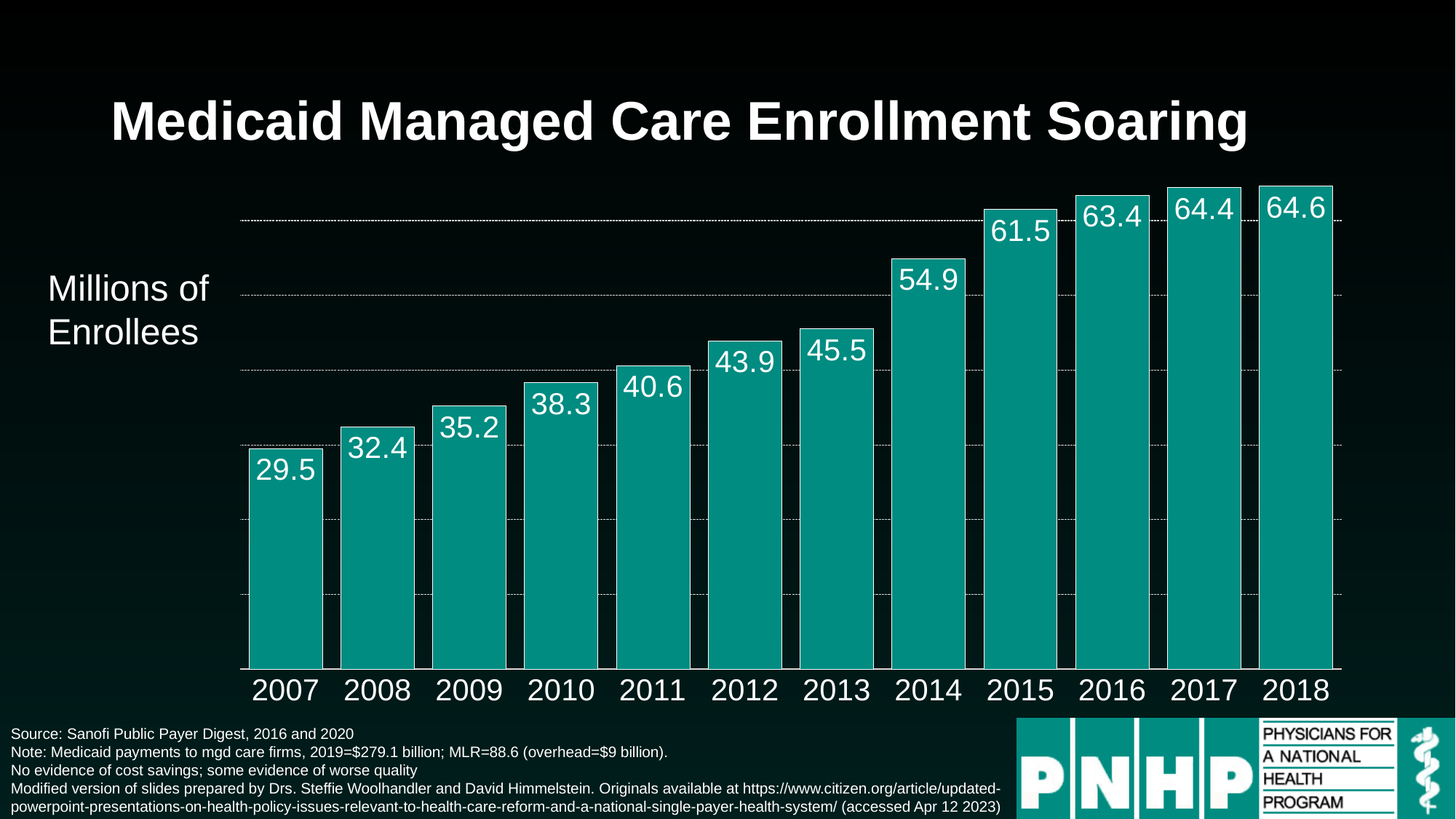
What is the value for 2007? 29.5 How many years are shown on the x axis? 12 Which is larger, the value for 2012 or the value for 2010? 2012 What is the value for 2011? 40.6 What is the value for 2014? 54.9 What is the difference between the values for 2018 and 2007? 35.1 What is the difference between the values for 2015 and 2014? 6.6 What kind of chart is this? bar chart Do the values rise or fall from 2007 to 2018? rise Which year has the highest value? 2018 What is the title of the chart? Medicaid Managed Care Enrollment Soaring Which year has the lowest value? 2007